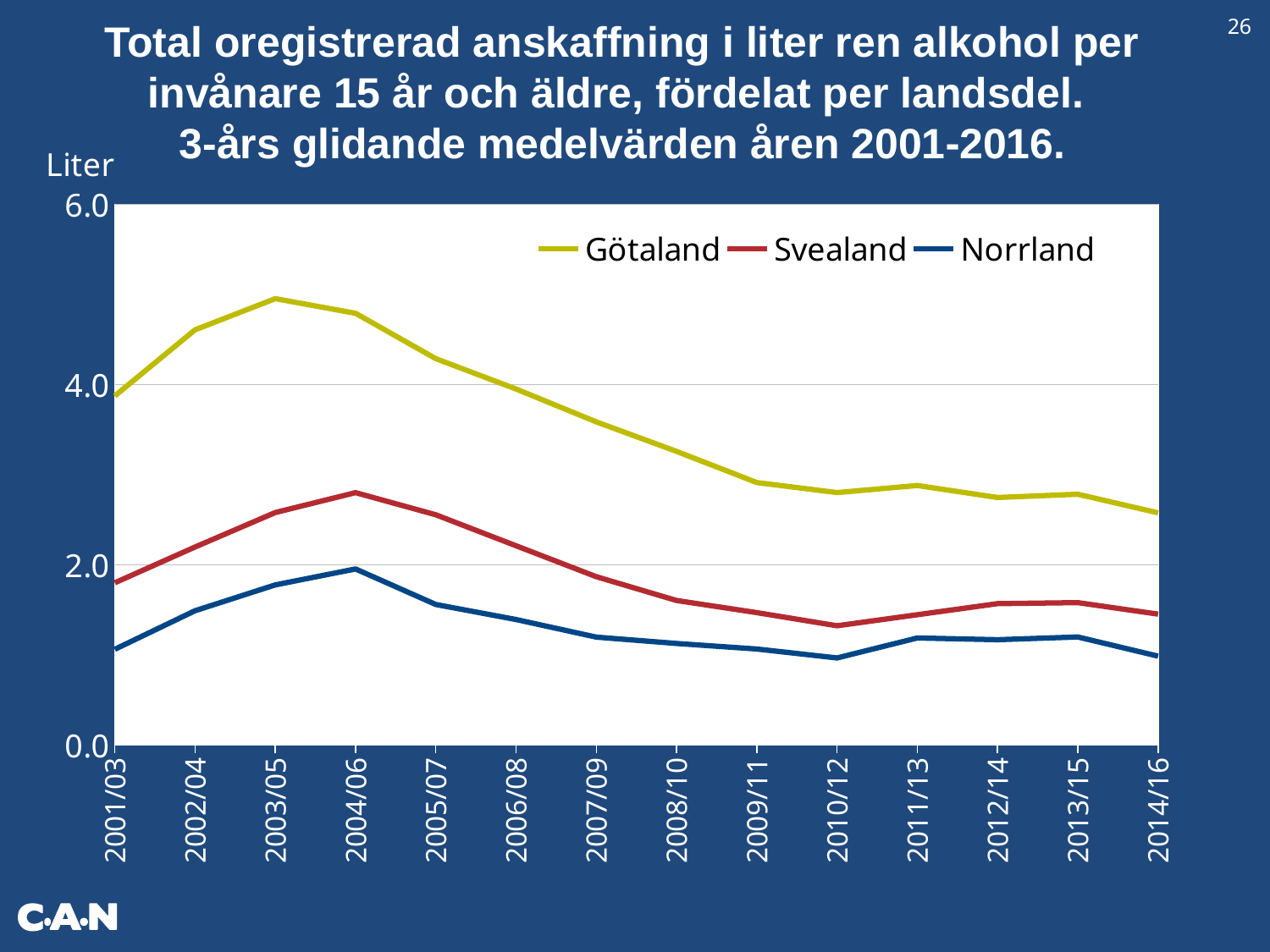
Which is larger in 2004/06, the value for Svealand or the value for Norrland? Svealand How many periods are shown along the x axis? 14 How many series does the legend list? 3 Is the value for Götaland in 2003/05 greater or less than 4.0? greater What kind of chart is shown on the slide? line chart Is the value for Svealand in 2010/12 greater or less than 2.0? less What unit is shown on the y axis label? Liter Does the Götaland line rise or fall between 2003/05 and 2009/11? fall Which series has the highest values across the whole period? Götaland In which period does the Götaland line reach its peak? 2003/05 Is the value for Götaland in 2009/11 greater or less than 4.0? less Which series has the lowest values across the whole period? Norrland